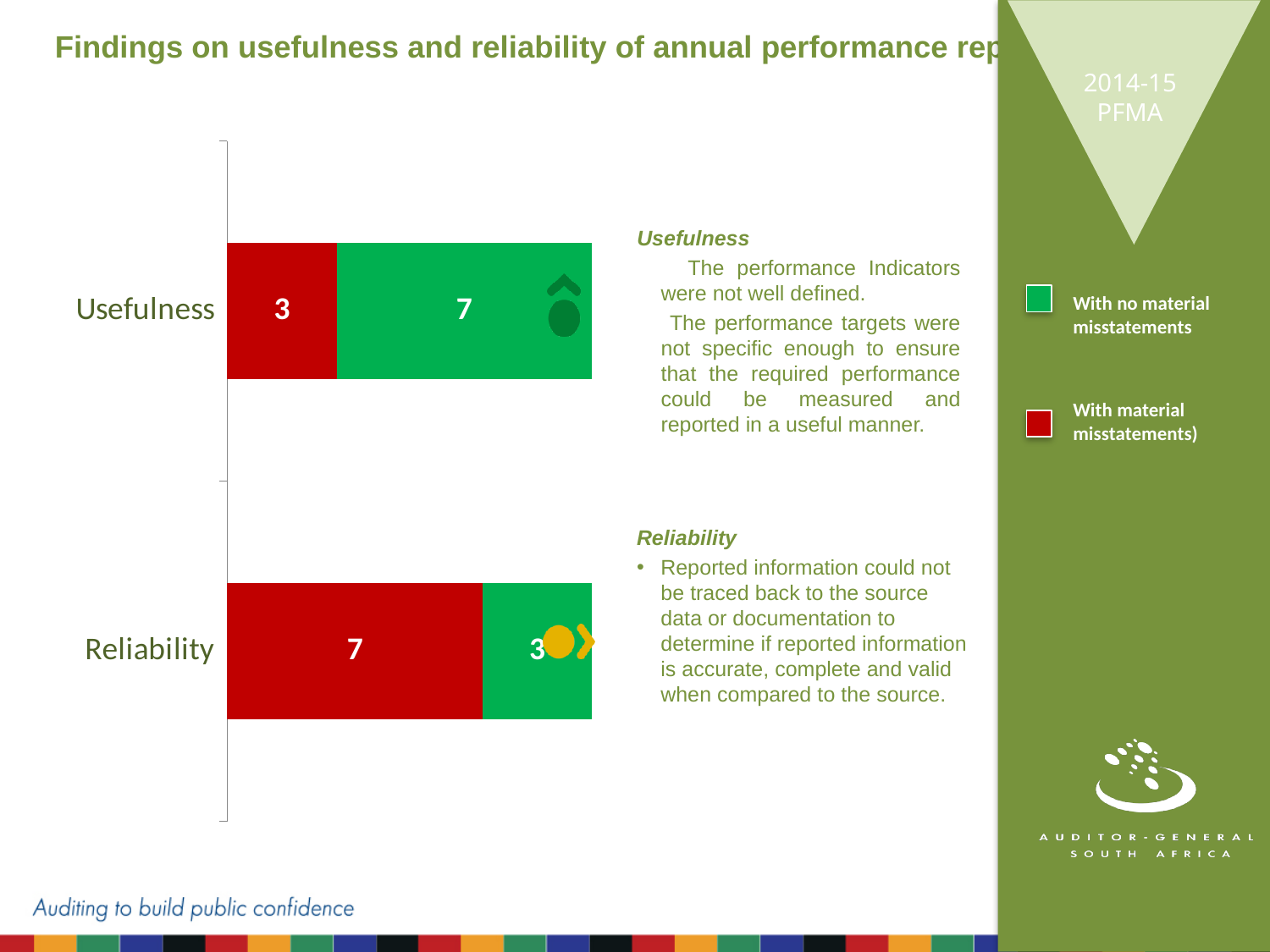
What is the total of the stacked bar for Reliability? 10 Which category has the larger green (with no material misstatements) segment, Usefulness or Reliability? Usefulness How many categories does the chart show? 2 What is the value of the red (with material misstatements) segment for Reliability? 7 What is the total of the stacked bar for Usefulness? 10 What kind of chart is shown on the slide? Stacked bar chart What is the value of the red (with material misstatements) segment for Usefulness? 3 What does the green colour in the legend represent? With no material misstatements What is the value of the green (with no material misstatements) segment for Reliability? 3 Which category has the highest value for material misstatements (red segment)? Reliability What is the value of the green (with no material misstatements) segment for Usefulness? 7 What is the difference between the red segment for Reliability and the red segment for Usefulness? 4